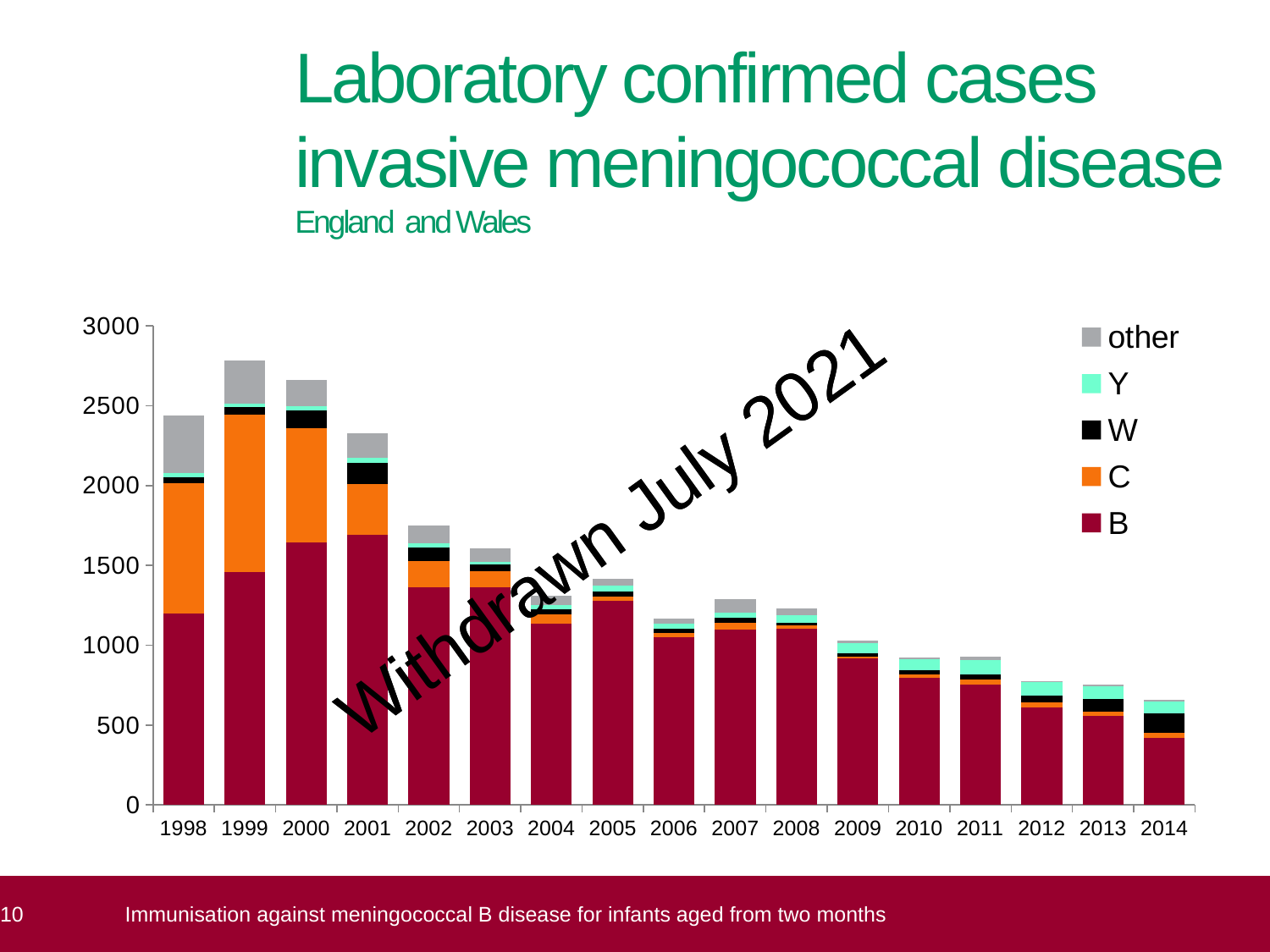
Do the total confirmed cases generally rise or fall from 1999 to 2014? fall Is the total bar height for 1998 greater or less than 2000? less Which year has the taller stacked bar, 1999 or 2000? 1999 How many years are shown along the x axis of the chart? 17 Is the total bar height for 2005 greater or less than 1500? less How many series does the chart legend list? 5 Is the total bar height for 2014 greater or less than 1000? less Which year has the tallest stacked bar (highest total of confirmed cases)? 1999 What kind of chart is shown on the slide? stacked bar chart Which series is shown at the bottom of each stacked bar in dark red? B Which year has the shortest stacked bar (lowest total of confirmed cases)? 2014